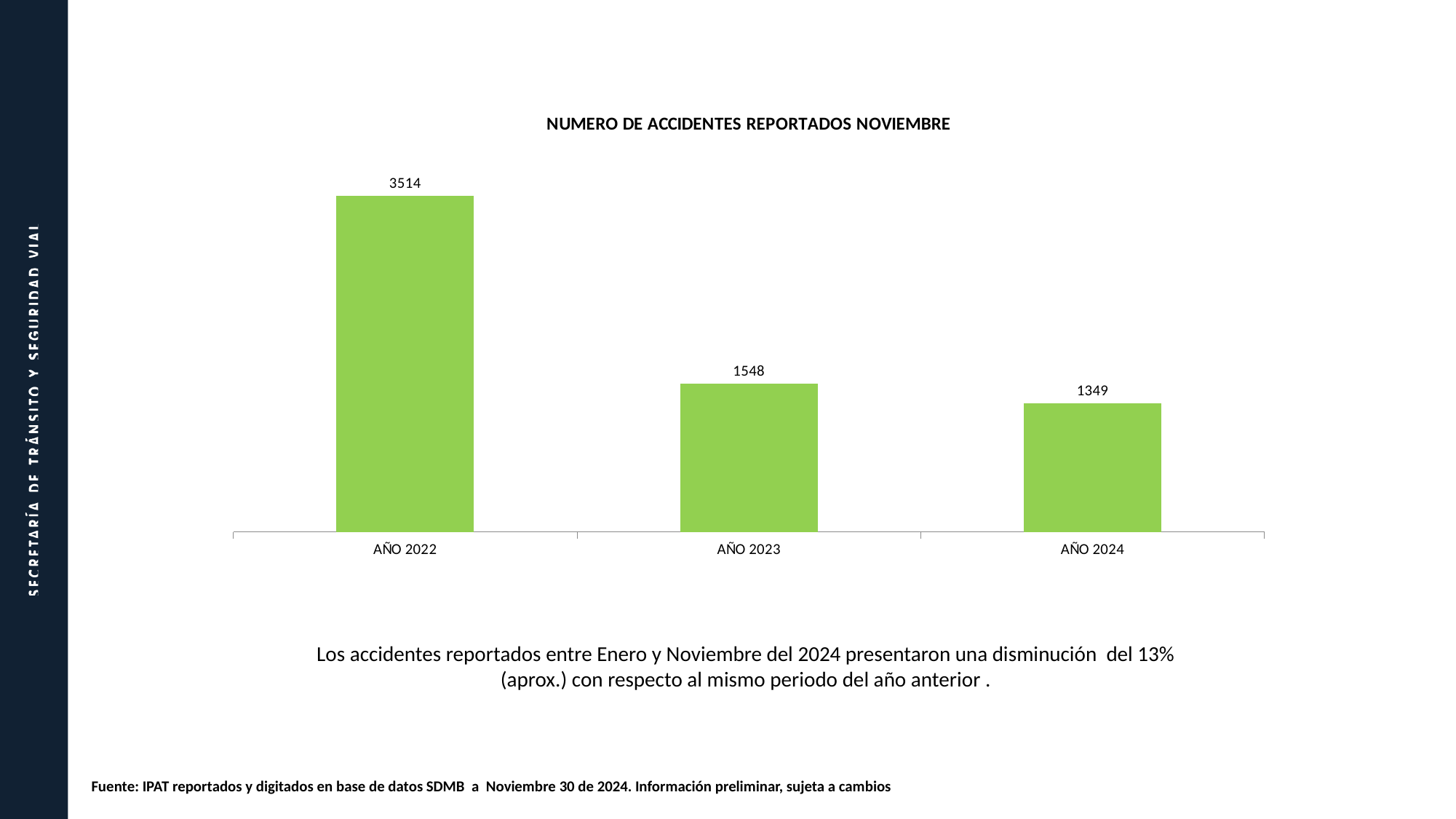
Which is larger, the value for AÑO 2022 or the value for AÑO 2024? AÑO 2022 Do the values rise or fall from AÑO 2022 to AÑO 2024? Fall What is the title of the chart? NUMERO DE ACCIDENTES REPORTADOS NOVIEMBRE What kind of chart is shown on the slide? Bar chart What is the value for AÑO 2024? 1349 What is the value for AÑO 2023? 1548 What is the difference between the values for AÑO 2023 and AÑO 2024? 199 Which year has the highest number of accidents reported? AÑO 2022 What is the difference between the values for AÑO 2022 and AÑO 2023? 1966 Which year has the lowest number of accidents reported? AÑO 2024 How many categories are shown on the x axis? 3 What is the value for AÑO 2022? 3514